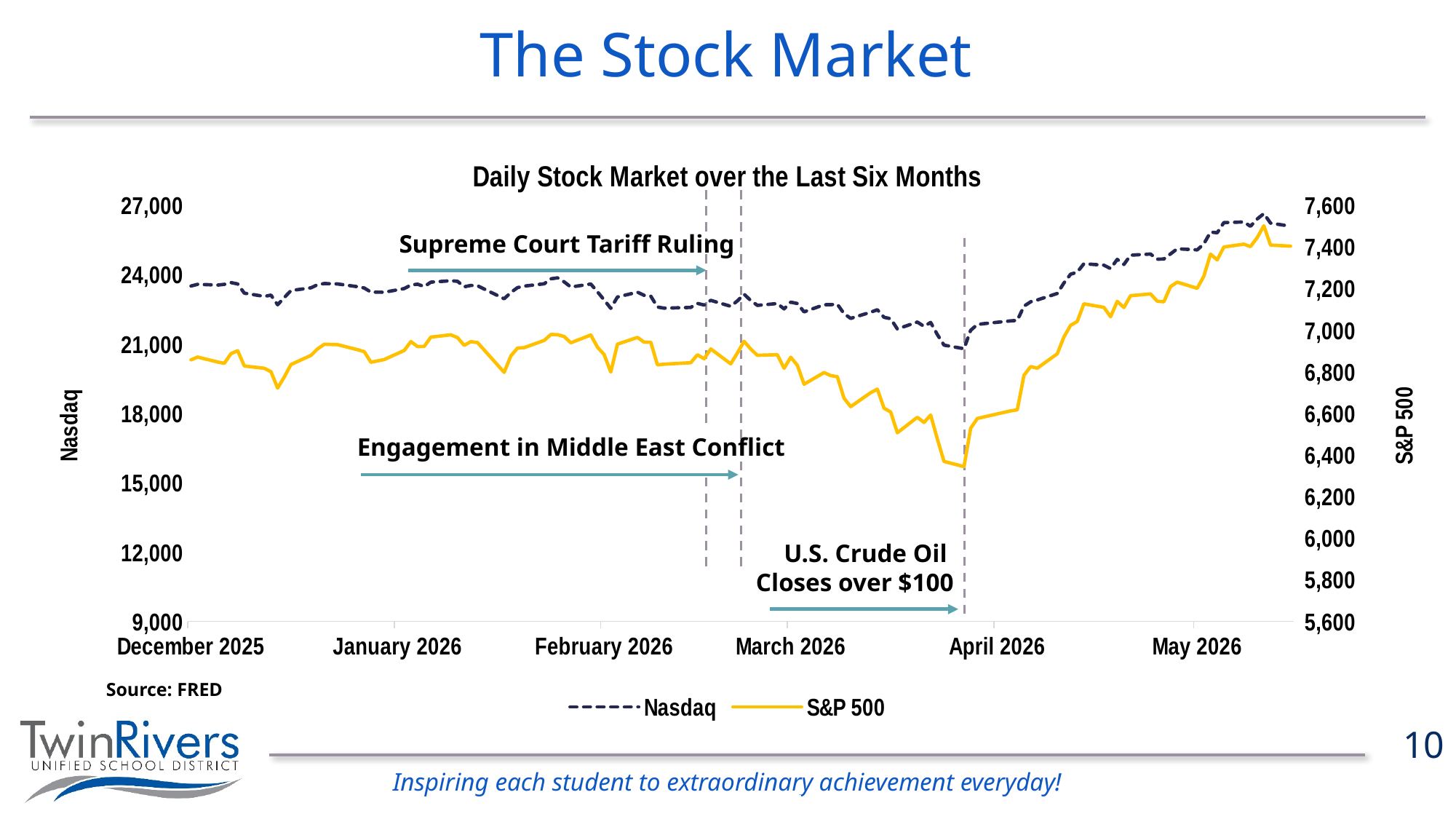
Is the S&P 500 value at the end of the chart greater or less than 7,200? greater Is the Nasdaq value at the start of December 2025 greater or less than 21,000? greater Which series is plotted with a dashed line? Nasdaq Does the Nasdaq rise or fall between April 2026 and May 2026? rise Is the lowest S&P 500 value, reached in late March 2026, greater or less than 6,600? less What kind of chart is shown on the slide? Line chart Is the S&P 500 higher at the end of the chart or at the start of December 2025? At the end of the chart Does the S&P 500 rise or fall between February 2026 and late March 2026? fall What is the title of the chart? Daily Stock Market over the Last Six Months How many series does the legend list? 2 How many month labels appear on the x axis? 6